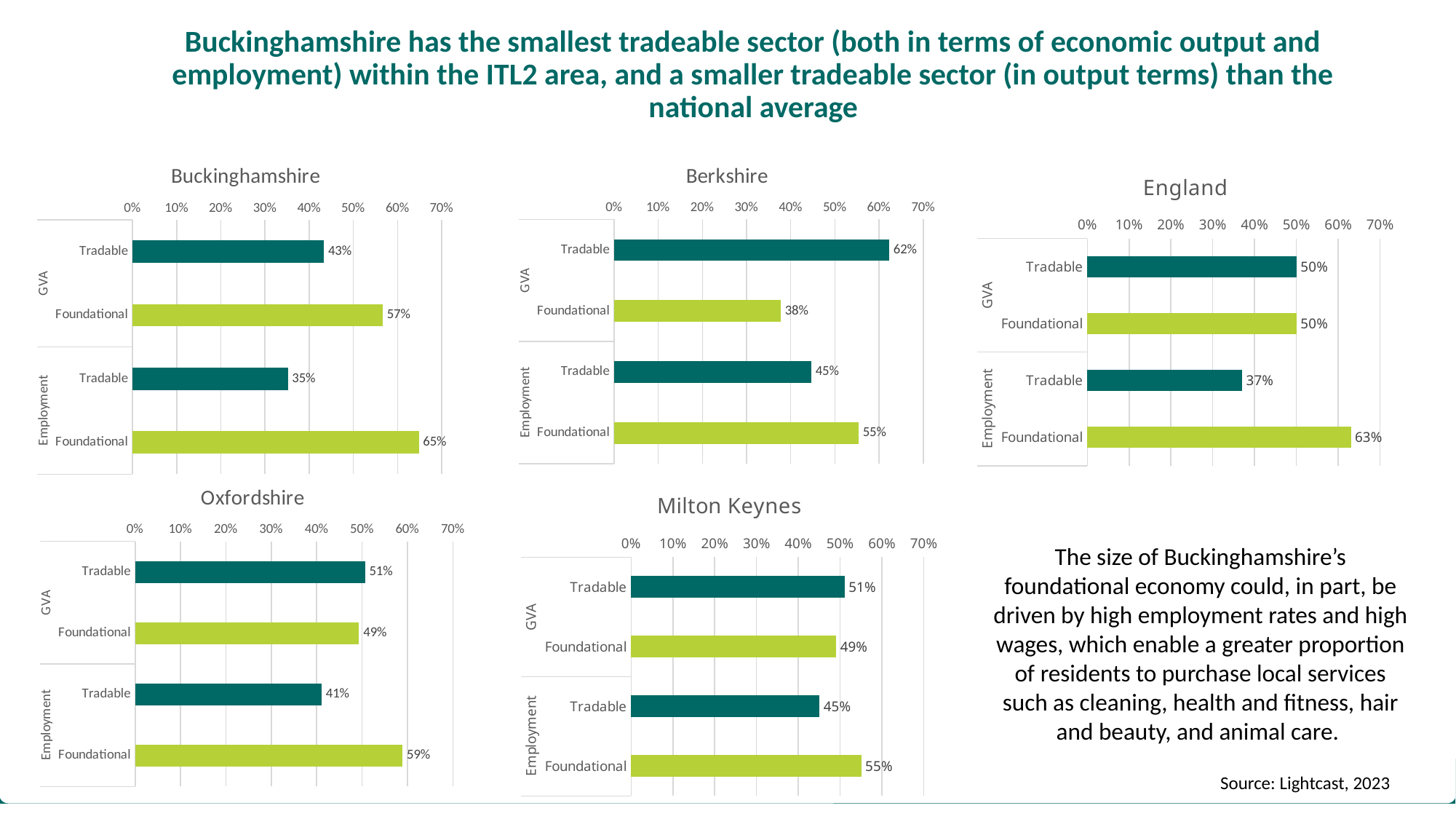
In the Berkshire chart, which bar has the lowest value? GVA Foundational In the England chart, what is the Employment value for Tradable? 37% In the Buckinghamshire chart, which bar has the highest value? Employment Foundational In the Berkshire chart, what is the GVA value for Tradable? 62% In the Berkshire chart, which is larger: the GVA Tradable value or the GVA Foundational value? GVA Tradable What type of chart is the England chart? Bar chart In the Oxfordshire chart, what is the Employment value for Foundational? 59% In the Buckinghamshire chart, what is the Employment value for Foundational? 65% In the Buckinghamshire chart, what is the difference between the Employment Foundational and Employment Tradable values? 30% In the Milton Keynes chart, what is the GVA value for Foundational? 49% In the Buckinghamshire chart, what is the GVA value for Tradable? 43% How many bars are plotted in the Oxfordshire chart? 4